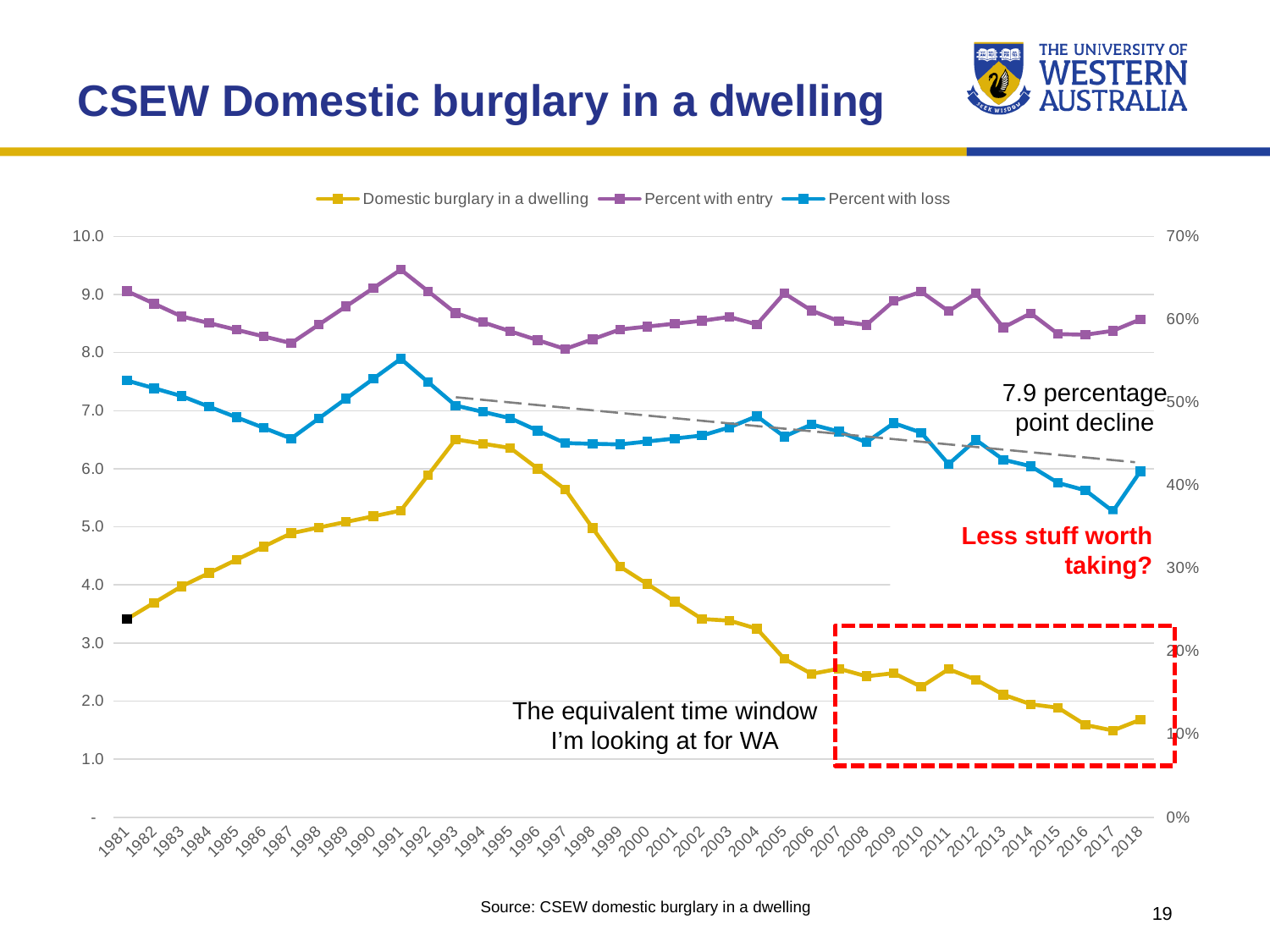
What kind of chart is shown on the slide? Line chart How many series does the chart legend list? 3 What decline does the annotation next to the dashed trend line state? 7.9 percentage point decline Is the value for Domestic burglary in a dwelling in 1993 greater or less than 6.0? greater In which year does the Domestic burglary in a dwelling series reach its highest value? 1993 Is the value for Domestic burglary in a dwelling in 2017 greater or less than 2.0? less In which year does the Percent with entry series reach its highest value? 1991 In which year is the Percent with loss series at its lowest? 2017 How many years are plotted along the x axis of the chart? 38 Which series is higher in 2018, Percent with entry or Percent with loss? Percent with entry Is the value for Percent with loss in 2017 greater or less than 40%? less Does the Domestic burglary in a dwelling series rise or fall between 1993 and 2018? Fall